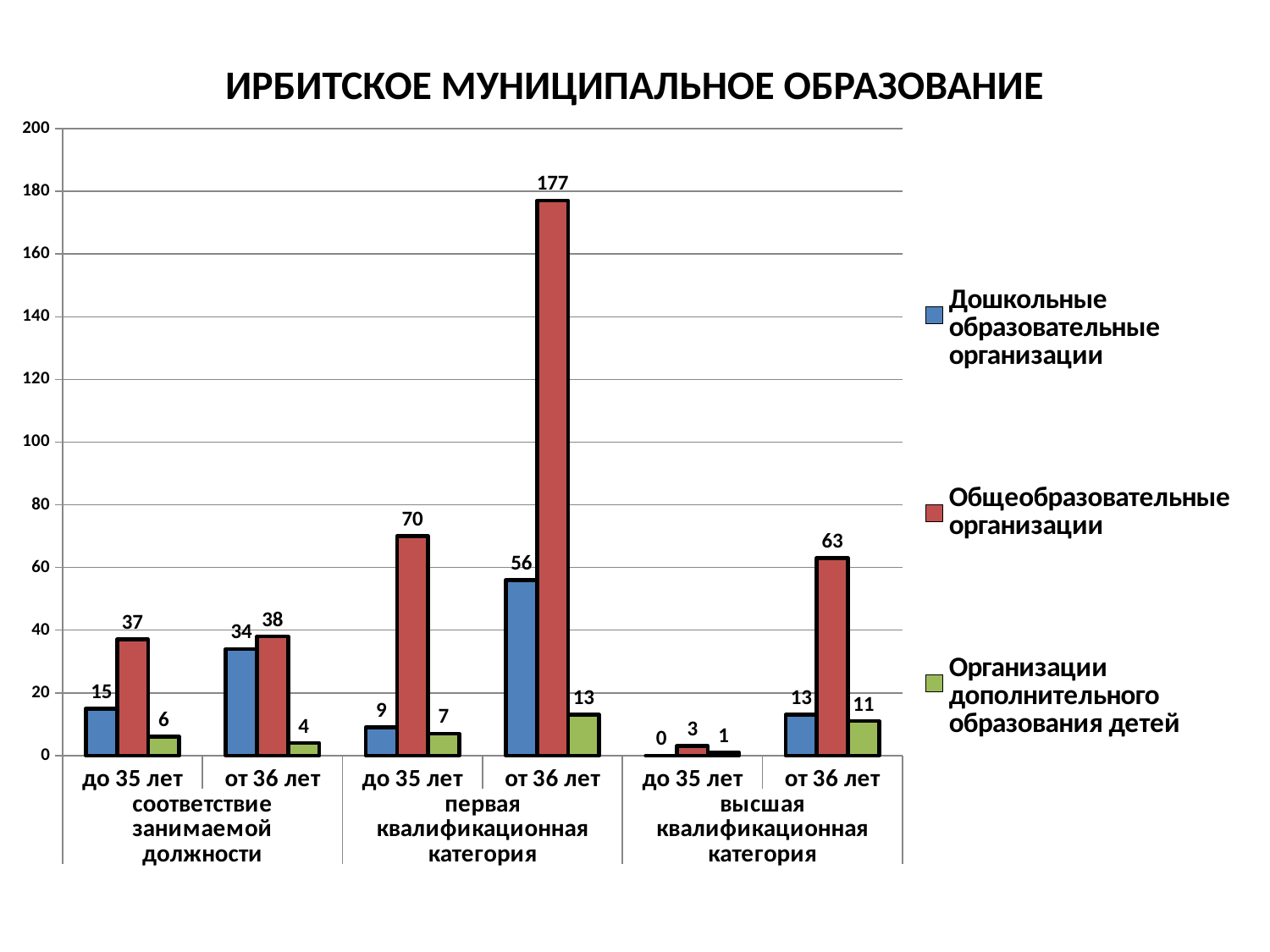
What is the value for Организации дополнительного образования детей in the 'от 36 лет' group of 'высшая квалификационная категория'? 11 What is the title of the chart? ИРБИТСКОЕ МУНИЦИПАЛЬНОЕ ОБРАЗОВАНИЕ What is the value for Общеобразовательные организации in the 'от 36 лет' group of 'первая квалификационная категория'? 177 In the 'до 35 лет' group of 'первая квалификационная категория', which is larger: Общеобразовательные организации or Дошкольные образовательные организации? Общеобразовательные организации Which group has the highest value for Общеобразовательные организации? от 36 лет, первая квалификационная категория How many series does the legend list? 3 What type of chart is shown on the slide? bar chart What is the difference between Общеобразовательные организации and Дошкольные образовательные организации in the 'от 36 лет' group of 'первая квалификационная категория'? 121 What is the difference between Дошкольные образовательные организации and Организации дополнительного образования детей in the 'от 36 лет' group of 'соответствие занимаемой должности'? 30 How many category groups are shown along the x axis? 6 Which group has the lowest value for Дошкольные образовательные организации? до 35 лет, высшая квалификационная категория What is the value for Дошкольные образовательные организации in the 'до 35 лет' group of 'соответствие занимаемой должности'? 15